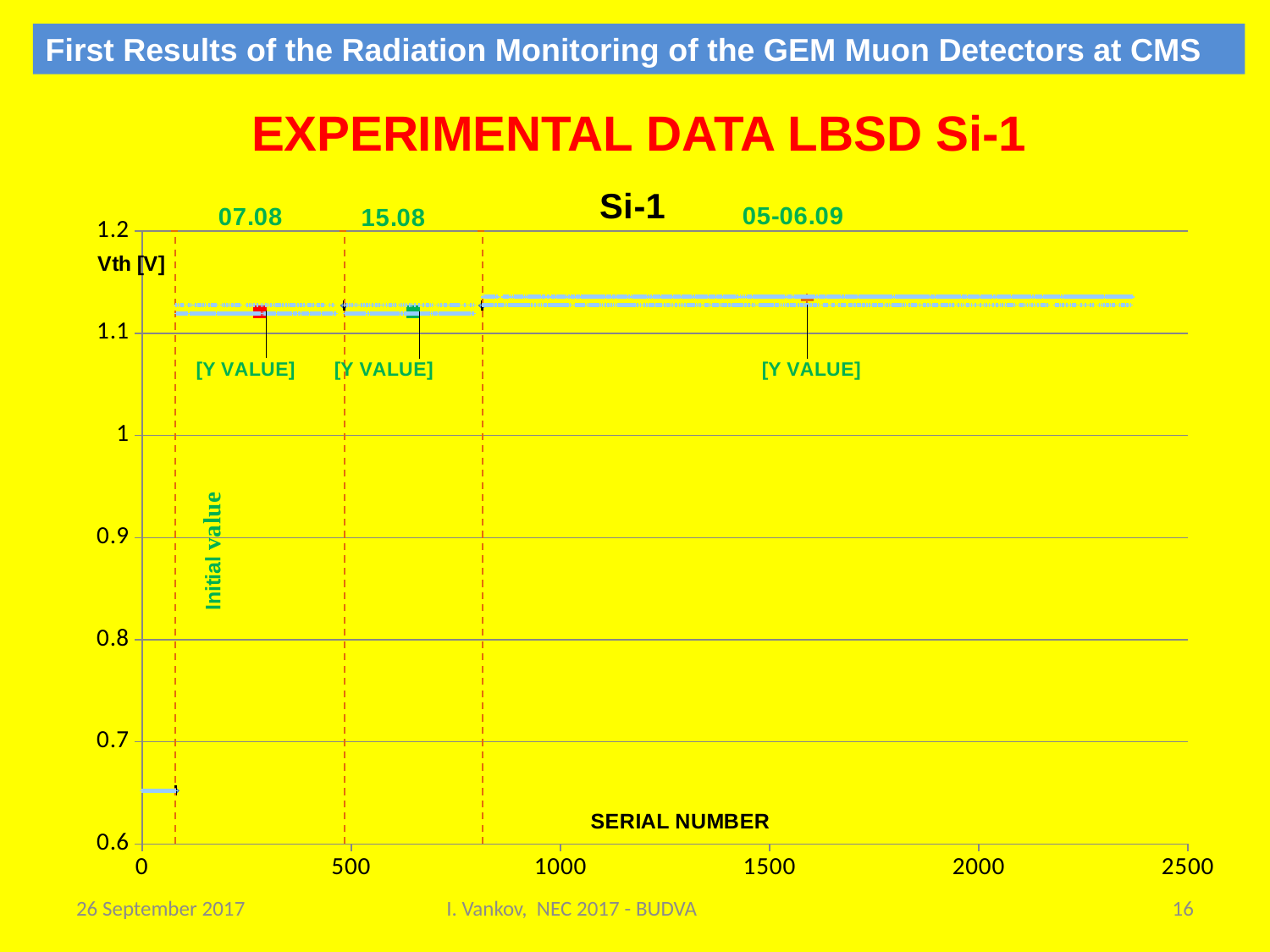
Is the Vth value of the point marked 'Initial value' near serial number 0 greater or less than 0.7? less What kind of chart is shown on the slide? scatter chart Which date label is placed above the rightmost group of points? 05-06.09 What is the label of the vertical axis of the chart? Vth [V] Are the Vth values of the main band of points greater or less than 1.1? greater What is the title of the chart? Si-1 How many dashed vertical lines divide the chart into date periods? 3 Is the Vth value of the point marked 'Initial value' near serial number 0 greater or less than 0.6? greater